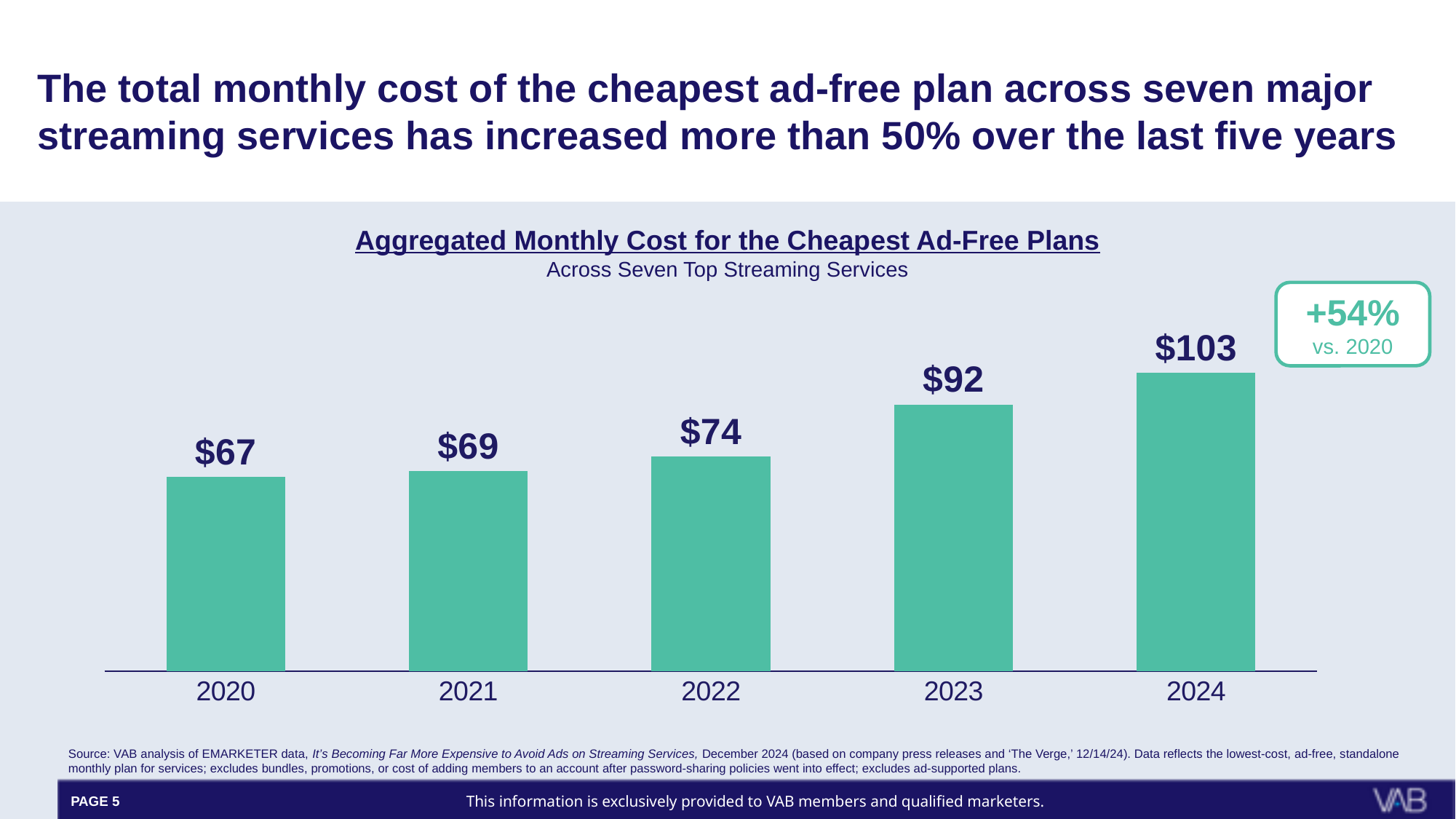
Which year has a higher aggregated monthly cost, 2021 or 2023? 2023 What is the aggregated monthly cost for the cheapest ad-free plans in 2022? $74 What is the aggregated monthly cost for the cheapest ad-free plans in 2020? $67 What is the aggregated monthly cost for the cheapest ad-free plans in 2024? $103 Which year has the highest aggregated monthly cost? 2024 How many years are shown on the chart? 5 Which year has the lowest aggregated monthly cost? 2020 What kind of chart is shown on the slide? Bar chart What is the difference between the aggregated monthly cost in 2024 and in 2020? $36 Do the aggregated monthly costs rise or fall from 2020 to 2024? Rise What is the difference between the aggregated monthly cost in 2023 and in 2022? $18 What percentage change vs. 2020 is shown in the callout box on the chart? +54%